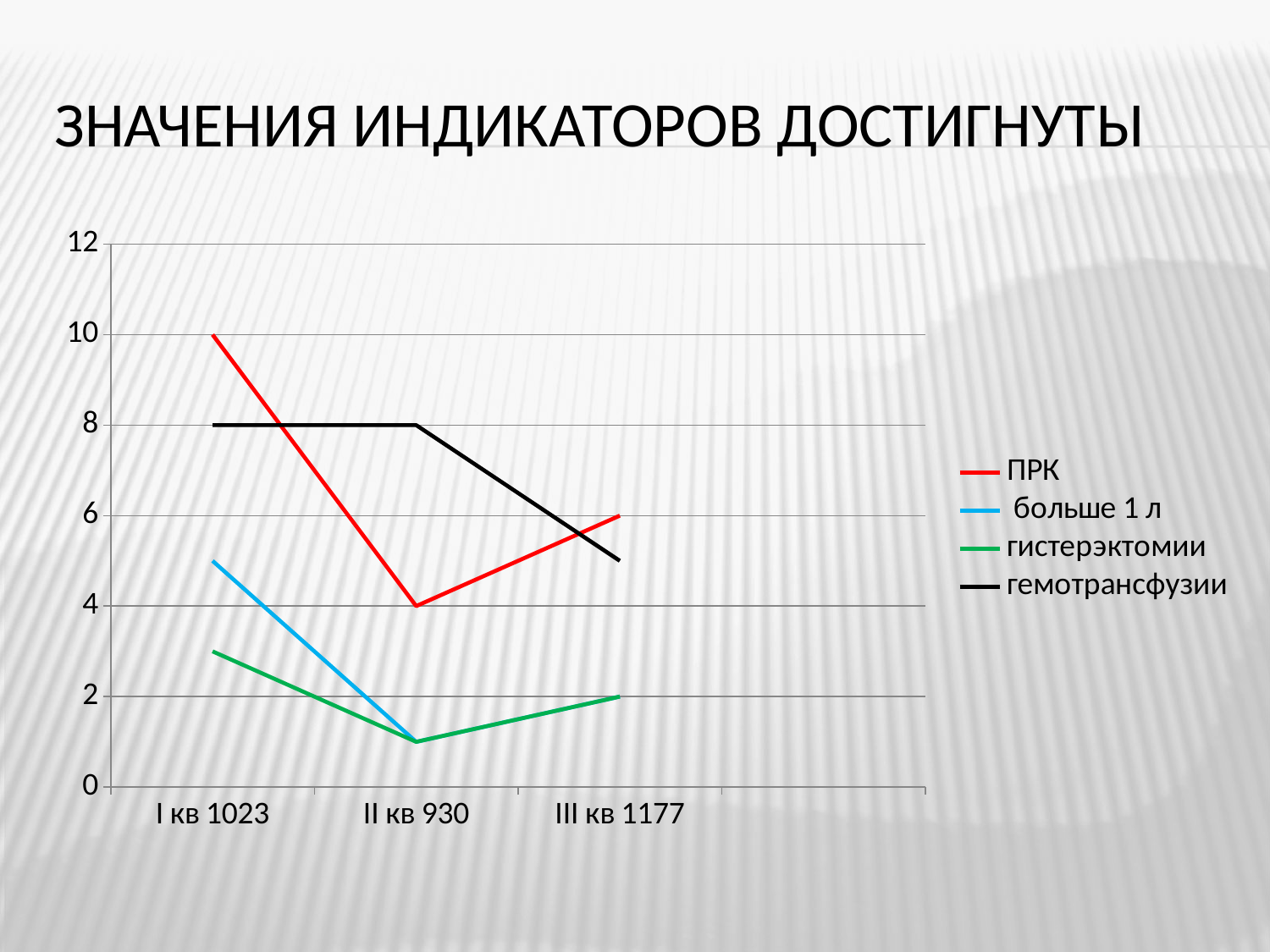
What is the difference between the ПРК values at I кв 1023 and II кв 930? 6 What is the value of гистерэктомии at III кв 1177? 2 Is the value for гемотрансфузии at III кв 1177 greater or less than 4? greater How many series does the legend list? 4 What is the value of гемотрансфузии at I кв 1023? 8 Which series has the highest value at I кв 1023? ПРК How many categories are shown on the x axis? 3 Which series has the lowest value at I кв 1023? гистерэктомии What is the value of ПРК at II кв 930? 4 What is the value of ПРК at I кв 1023? 10 Does the гемотрансфузии line rise or fall between II кв 930 and III кв 1177? fall What kind of chart is shown on the slide? line chart